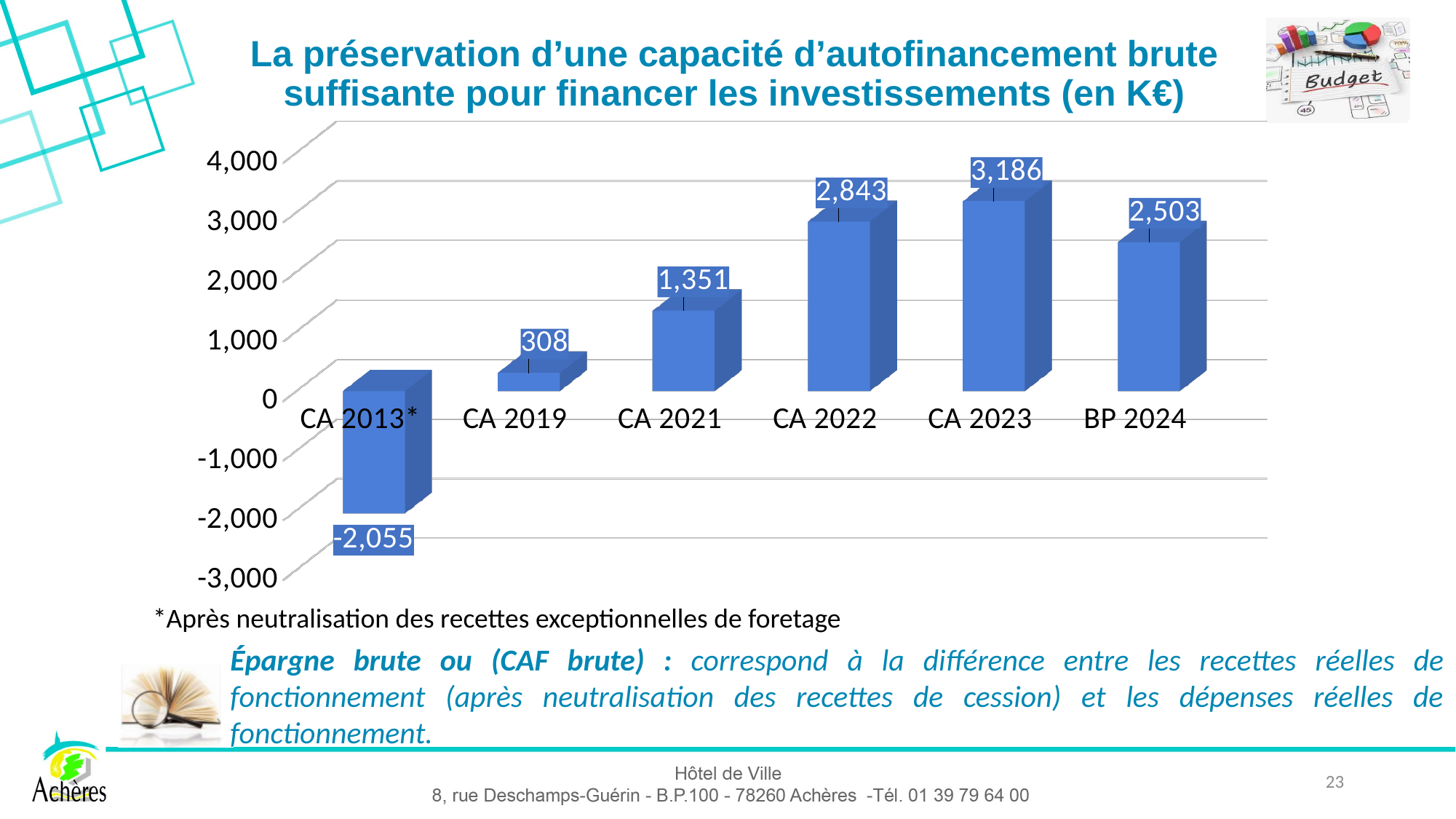
Do the values rise or fall from CA 2013* to CA 2023? Rise What is the value for BP 2024? 2,503 What is the difference between the values for CA 2023 and CA 2022? 343 What is the value for CA 2019? 308 What is the value for CA 2023? 3,186 Which category has the highest value? CA 2023 Which category has the lowest value? CA 2013* How many categories are shown on the x axis? 6 What kind of chart is shown on the slide? Bar chart What is the difference between the values for CA 2022 and CA 2021? 1,492 Which is larger, the value for CA 2022 or the value for BP 2024? CA 2022 What is the value for CA 2013*? -2,055